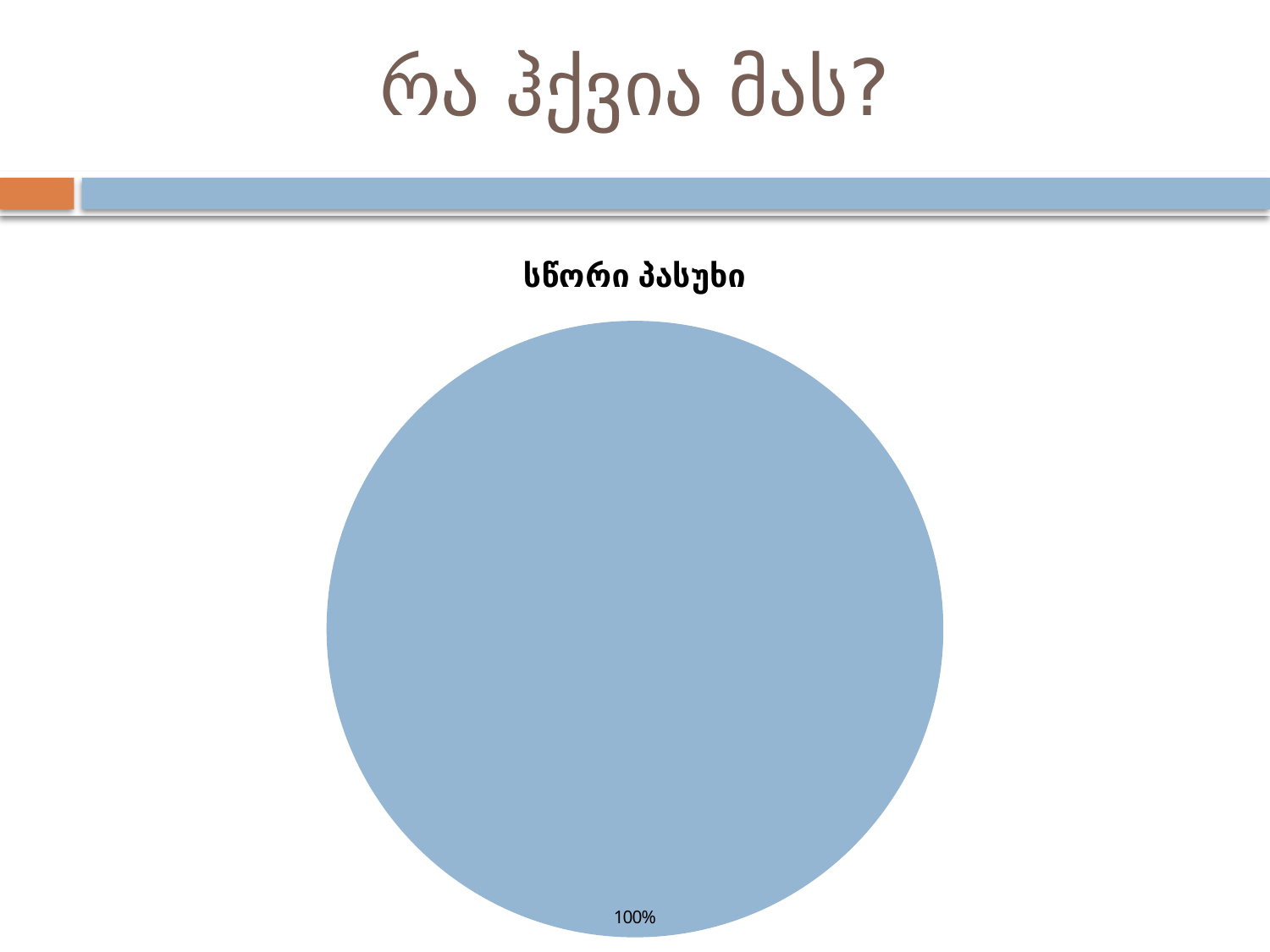
What colour is the slice of the pie chart? light blue What percentage is printed as the data label on the pie chart? 100% What kind of chart is shown on the slide? pie chart What share of the pie does the single slice represent? 100% What is the title of the pie chart? სწორი პასუხი How many slices does the pie chart contain? 1